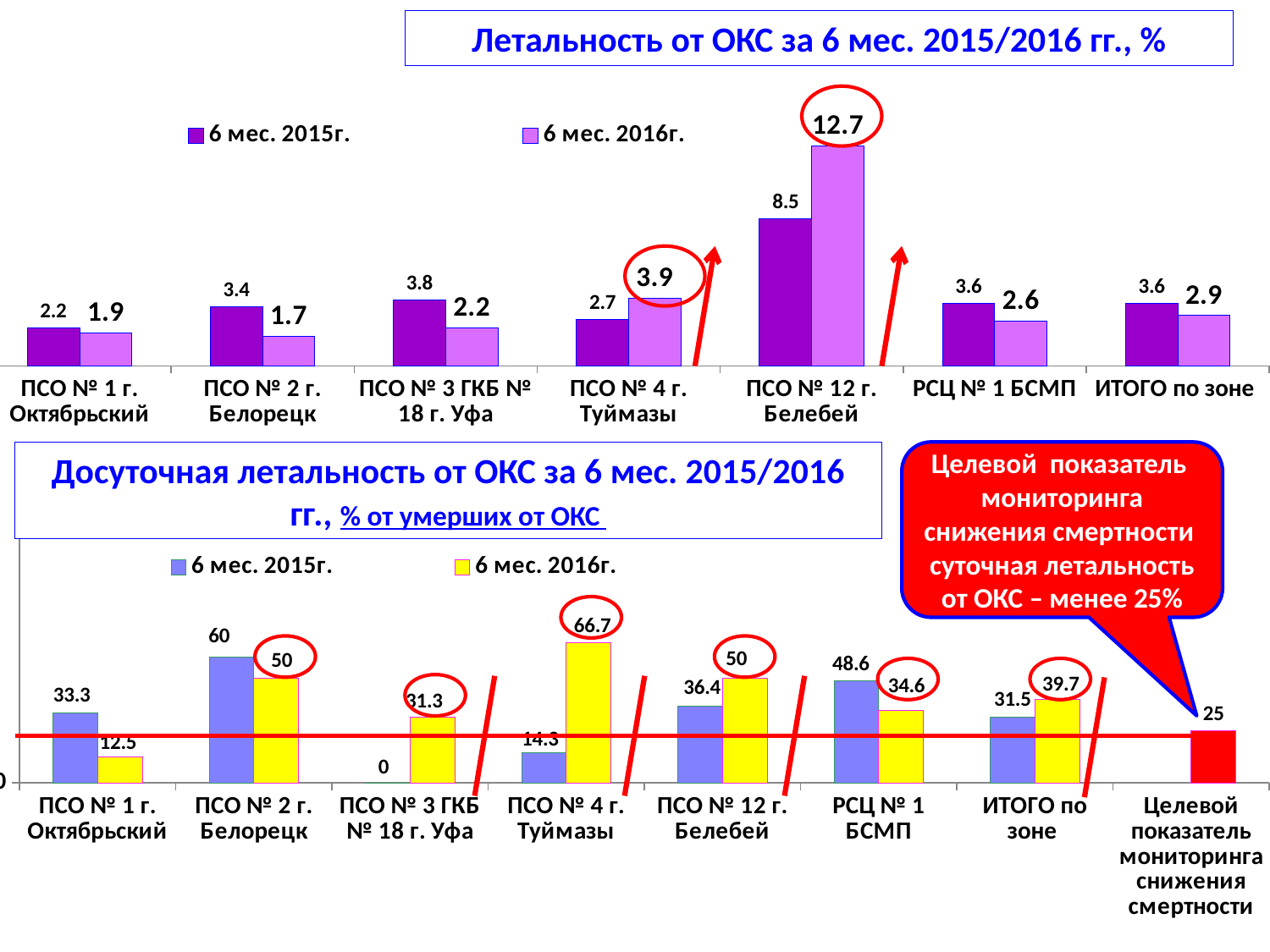
In the top chart 'Летальность от ОКС за 6 мес. 2015/2016 гг., %', which category has the lowest value for 6 мес. 2016г.? ПСО № 2 г. Белорецк In the top chart 'Летальность от ОКС за 6 мес. 2015/2016 гг., %', what is the value for ПСО № 3 ГКБ № 18 г. Уфа for 6 мес. 2015г.? 3.8 In the top chart 'Летальность от ОКС за 6 мес. 2015/2016 гг., %', what is the value for ПСО № 12 г. Белебей for 6 мес. 2016г.? 12.7 In the bottom chart 'Досуточная летальность от ОКС', what is the value for ПСО № 4 г. Туймазы for 6 мес. 2016г.? 66.7 In the bottom chart 'Досуточная летальность от ОКС', which category has the highest value for 6 мес. 2015г.? ПСО № 2 г. Белорецк In the top chart 'Летальность от ОКС за 6 мес. 2015/2016 гг., %', which category has the highest value for 6 мес. 2016г.? ПСО № 12 г. Белебей What type of chart is the top chart 'Летальность от ОКС за 6 мес. 2015/2016 гг., %'? Bar chart In the bottom chart 'Досуточная летальность от ОКС', what is the value for ПСО № 3 ГКБ № 18 г. Уфа for 6 мес. 2015г.? 0 In the top chart 'Летальность от ОКС за 6 мес. 2015/2016 гг., %', what is the difference between the 6 мес. 2016г. and 6 мес. 2015г. values for ПСО № 12 г. Белебей? 4.2 In the bottom chart 'Досуточная летальность от ОКС', what is the value of the Целевой показатель мониторинга снижения смертности bar? 25 In the bottom chart 'Досуточная летальность от ОКС', which is larger for РСЦ № 1 БСМП: the 6 мес. 2015г. value or the 6 мес. 2016г. value? 6 мес. 2015г. In the top chart 'Летальность от ОКС за 6 мес. 2015/2016 гг., %', how many series does the legend list? 2